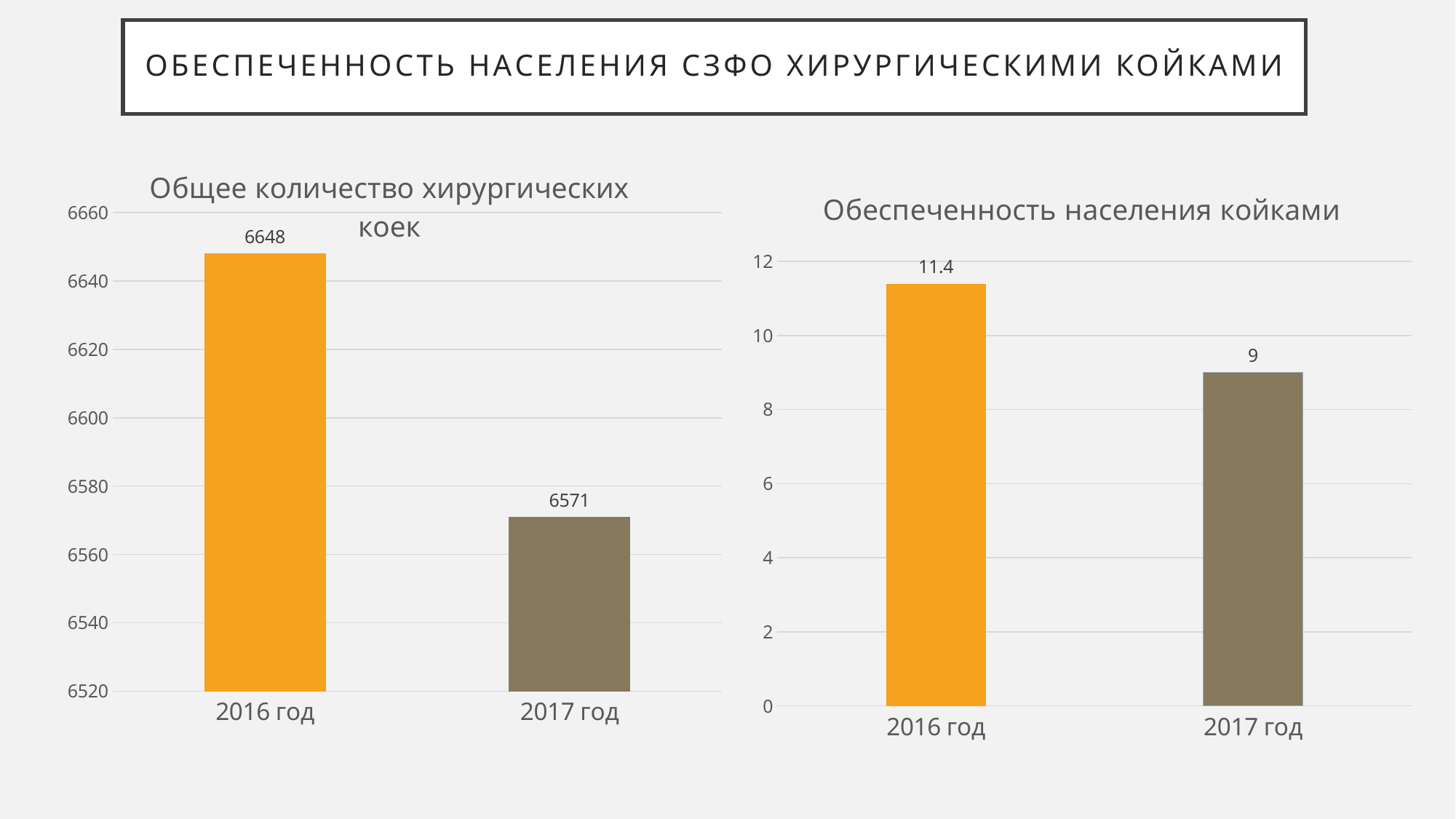
In the chart titled "Обеспеченность населения койками", what is the difference between the 2016 год and 2017 год values? 2.4 In the chart titled "Обеспеченность населения койками", is the value for 2016 год greater or less than 10? greater How many categories are shown in the chart titled "Общее количество хирургических коек"? 2 In the chart titled "Общее количество хирургических коек", what is the difference between the 2016 год and 2017 год values? 77 In the chart titled "Общее количество хирургических коек", do the values rise or fall from 2016 год to 2017 год? fall In the chart titled "Общее количество хирургических коек", what is the value for 2017 год? 6571 In the chart titled "Обеспеченность населения койками", which year has the lower value? 2017 год In the chart titled "Обеспеченность населения койками", what is the value for 2017 год? 9 In the chart titled "Общее количество хирургических коек", what is the value for 2016 год? 6648 What kind of chart is the chart titled "Обеспеченность населения койками"? bar chart In the chart titled "Общее количество хирургических коек", which year has the higher value? 2016 год In the chart titled "Обеспеченность населения койками", what is the value for 2016 год? 11.4